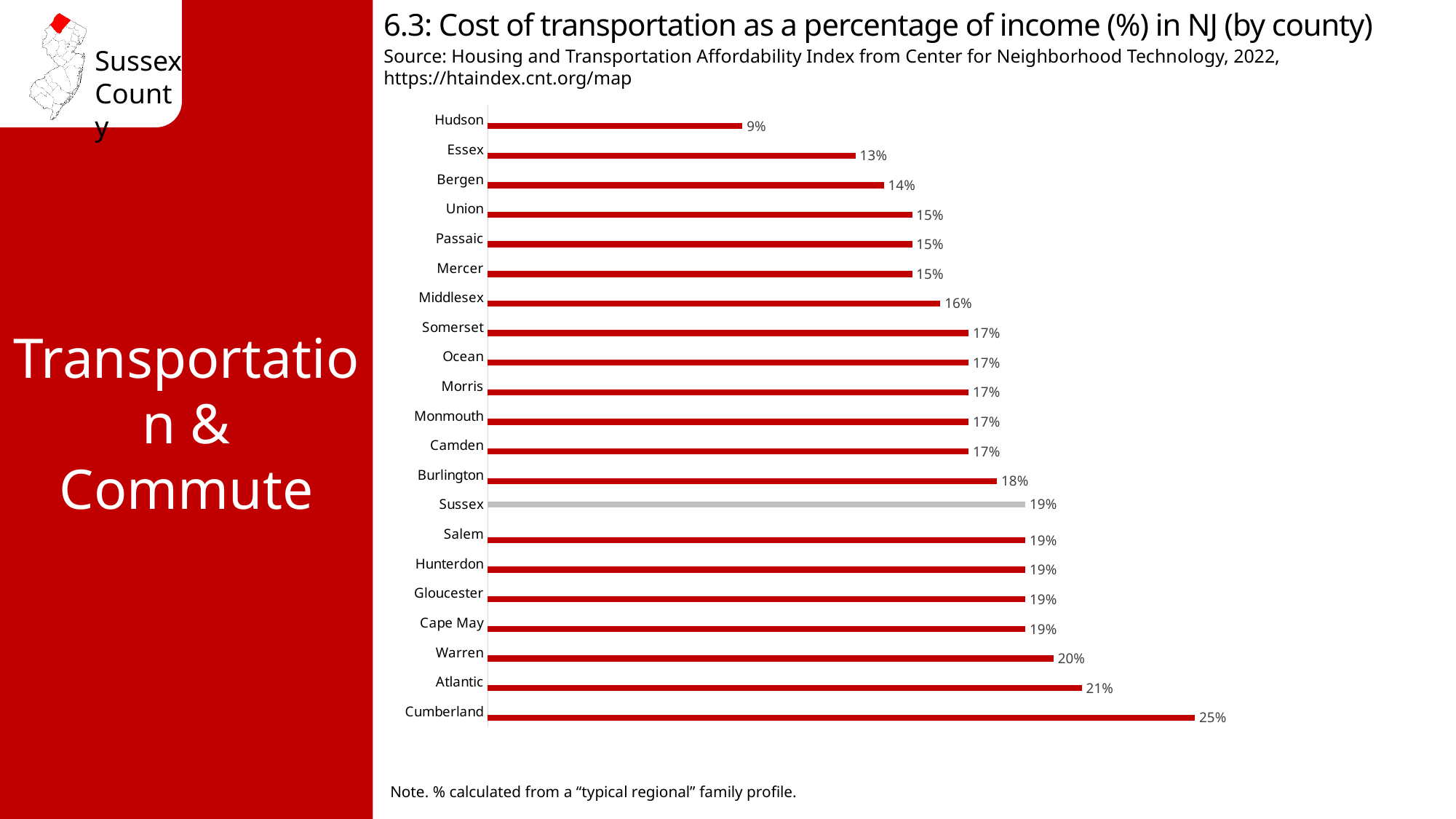
Which county has the lowest cost of transportation as a percentage of income? Hudson Which has a higher value, Essex or Bergen? Bergen Which county has the highest cost of transportation as a percentage of income? Cumberland What is the difference between the values for Atlantic and Sussex? 2% What is the value shown for Middlesex County? 16% What is the difference between the values for Cumberland and Hudson? 16% How many counties are shown in the chart? 21 What is the value shown for Hudson County? 9% What is the cost of transportation as a percentage of income for Sussex County? 19% Which has a higher value, Warren or Burlington? Warren Which county's bar is shown in grey rather than red? Sussex What kind of chart is shown on the slide? Bar chart